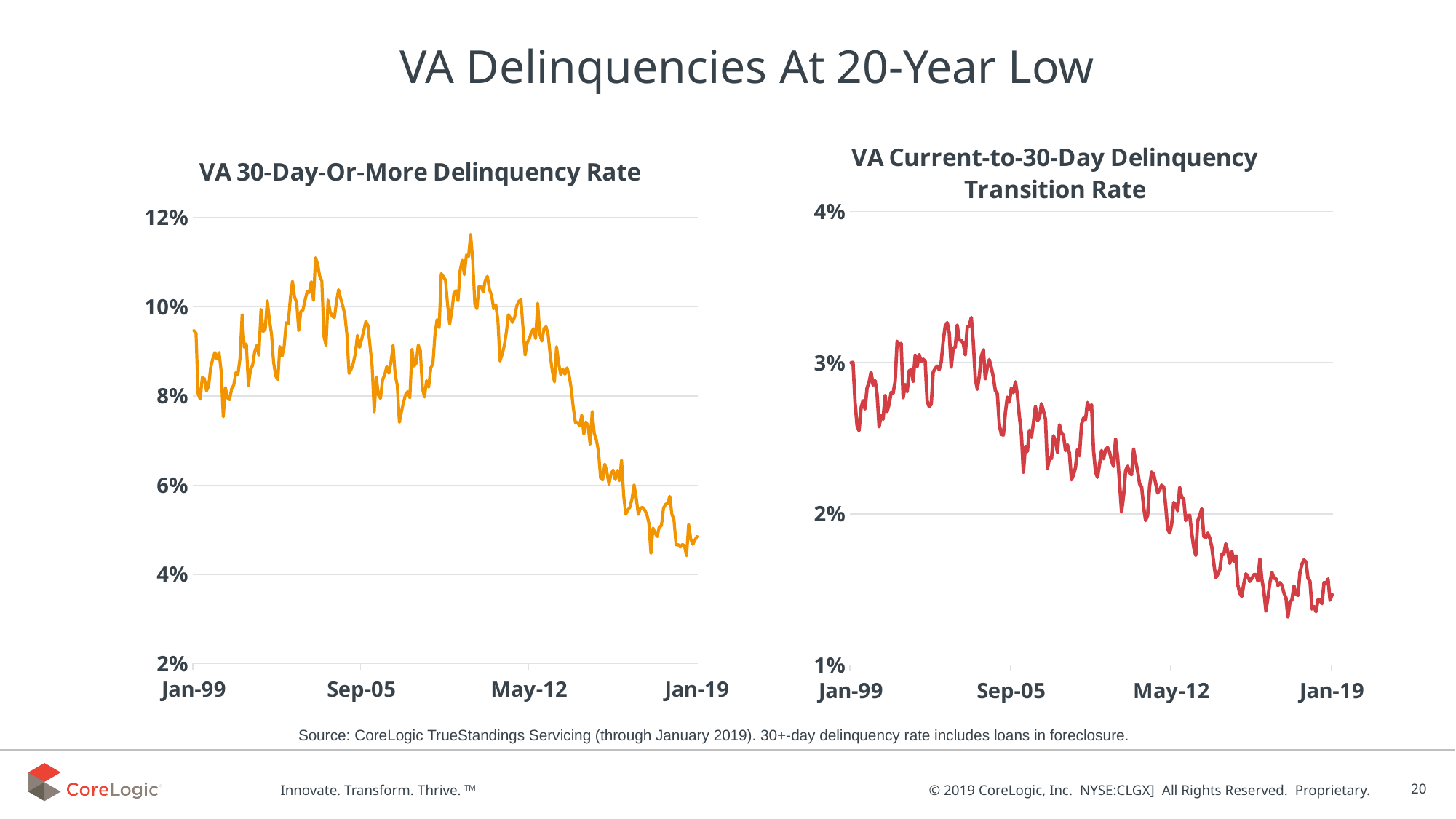
In the 'VA 30-Day-Or-More Delinquency Rate' chart, is the value at Jan-99 greater or less than 8%? greater What kind of chart is the 'VA 30-Day-Or-More Delinquency Rate' chart on the left? line chart In the 'VA 30-Day-Or-More Delinquency Rate' chart, is the highest point of the line greater or less than 10%? greater What is the title of the chart on the right side of the slide? VA Current-to-30-Day Delinquency Transition Rate In the 'VA Current-to-30-Day Delinquency Transition Rate' chart, does the line overall rise or fall from Jan-99 to Jan-19? fall What colour is the line in the 'VA 30-Day-Or-More Delinquency Rate' chart? orange In the 'VA 30-Day-Or-More Delinquency Rate' chart, is the value at Jan-19 greater or less than 6%? less What kind of chart is the 'VA Current-to-30-Day Delinquency Transition Rate' chart on the right? line chart In the 'VA 30-Day-Or-More Delinquency Rate' chart, does the line overall rise or fall between May-12 and Jan-19? fall